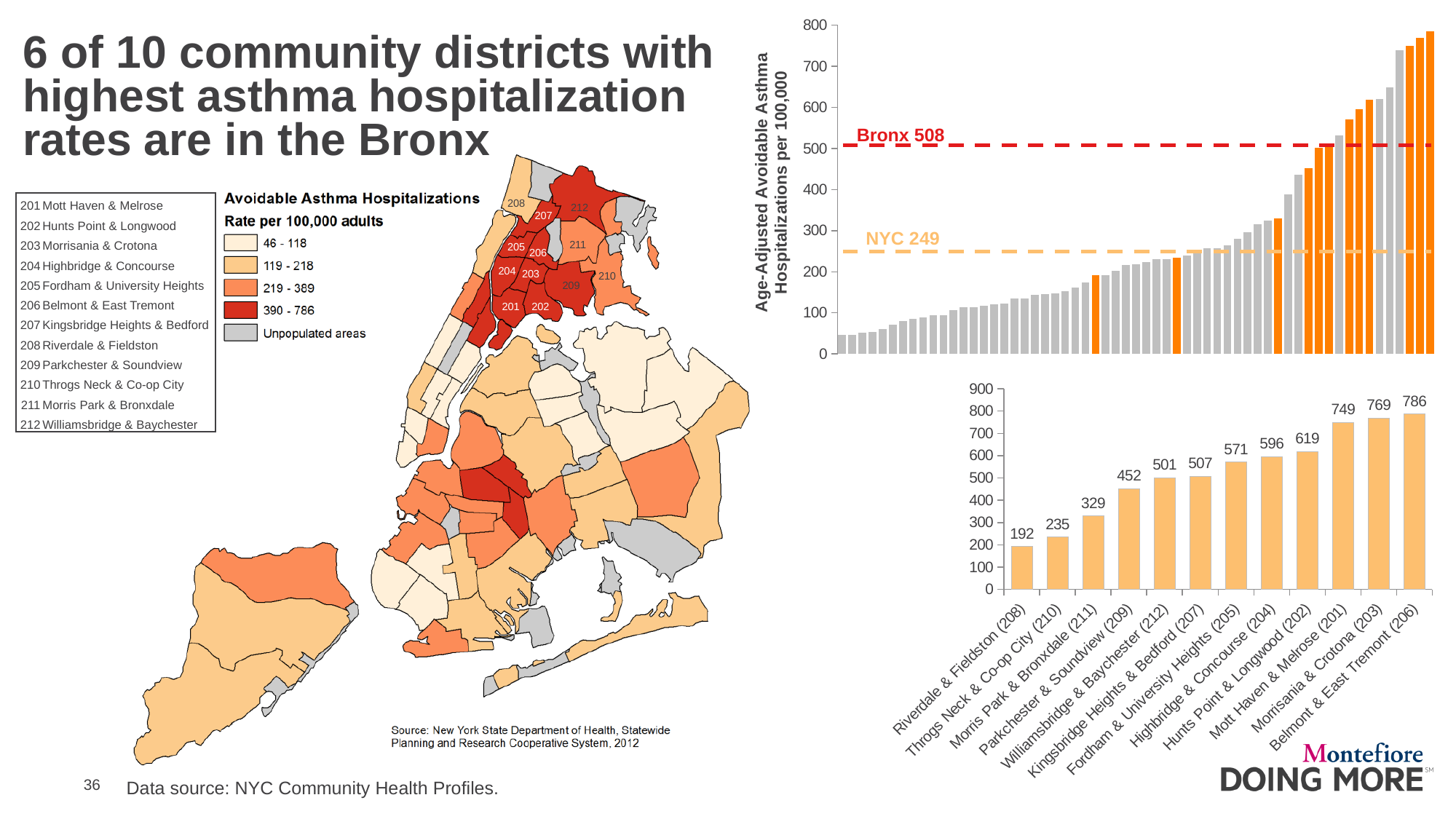
In the top-right bar chart, what value is labeled on the dashed reference line for NYC? 249 In the bottom-right bar chart, which is larger: Parkchester & Soundview (209) or Morris Park & Bronxdale (211)? Parkchester & Soundview (209) In the bottom-right bar chart, which community district has the lowest value? Riverdale & Fieldston (208) In the bottom-right bar chart, what is the value for Belmont & East Tremont (206)? 786 In the bottom-right bar chart, do the values rise or fall from left to right? rise In the bottom-right bar chart, what is the difference between Morrisania & Crotona (203) and Mott Haven & Melrose (201)? 20 In the bottom-right bar chart, what is the value for Hunts Point & Longwood (202)? 619 In the bottom-right bar chart, what is the value for Riverdale & Fieldston (208)? 192 What kind of chart is the bottom-right chart? bar chart How many community districts are shown in the bottom-right bar chart? 12 In the top-right bar chart, what value is labeled on the red dashed reference line for the Bronx? 508 In the bottom-right bar chart, which community district has the highest value? Belmont & East Tremont (206)